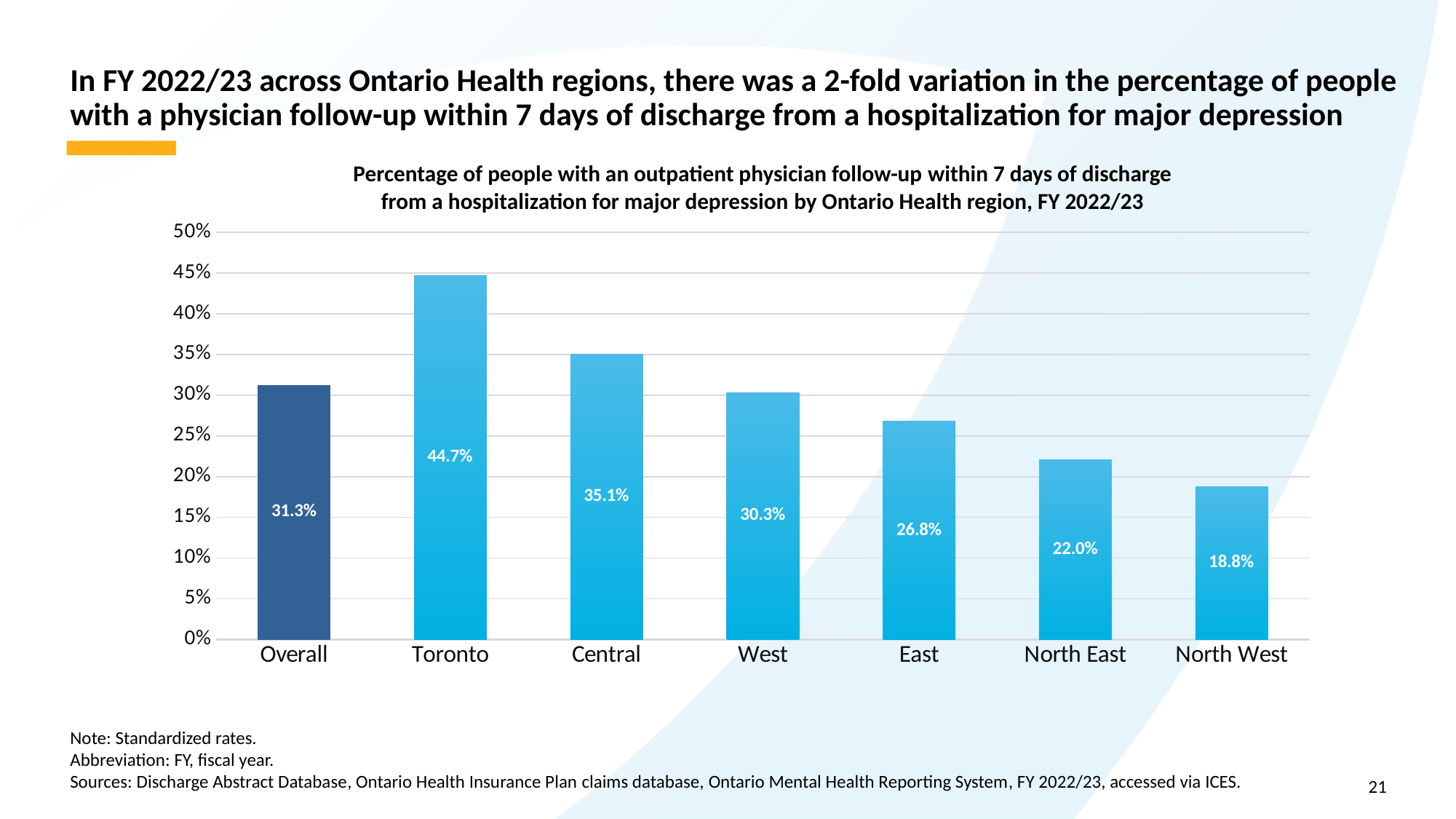
What is the difference between the Toronto and North West percentages? 25.9% How many bars are shown in the chart? 7 Is the value for Central greater or less than 30%? greater Which is larger, the value for East or the value for West? West What type of chart is shown on the slide? Bar chart What is the percentage for Toronto? 44.7% What is the value shown for the Overall bar? 31.3% What percentage is shown for North East? 22.0% Which region has the highest percentage of people with a physician follow-up within 7 days? Toronto Which bar is shown in a darker blue colour than the others? Overall Which region has the lowest percentage? North West What is the difference between the Central and West values? 4.8%